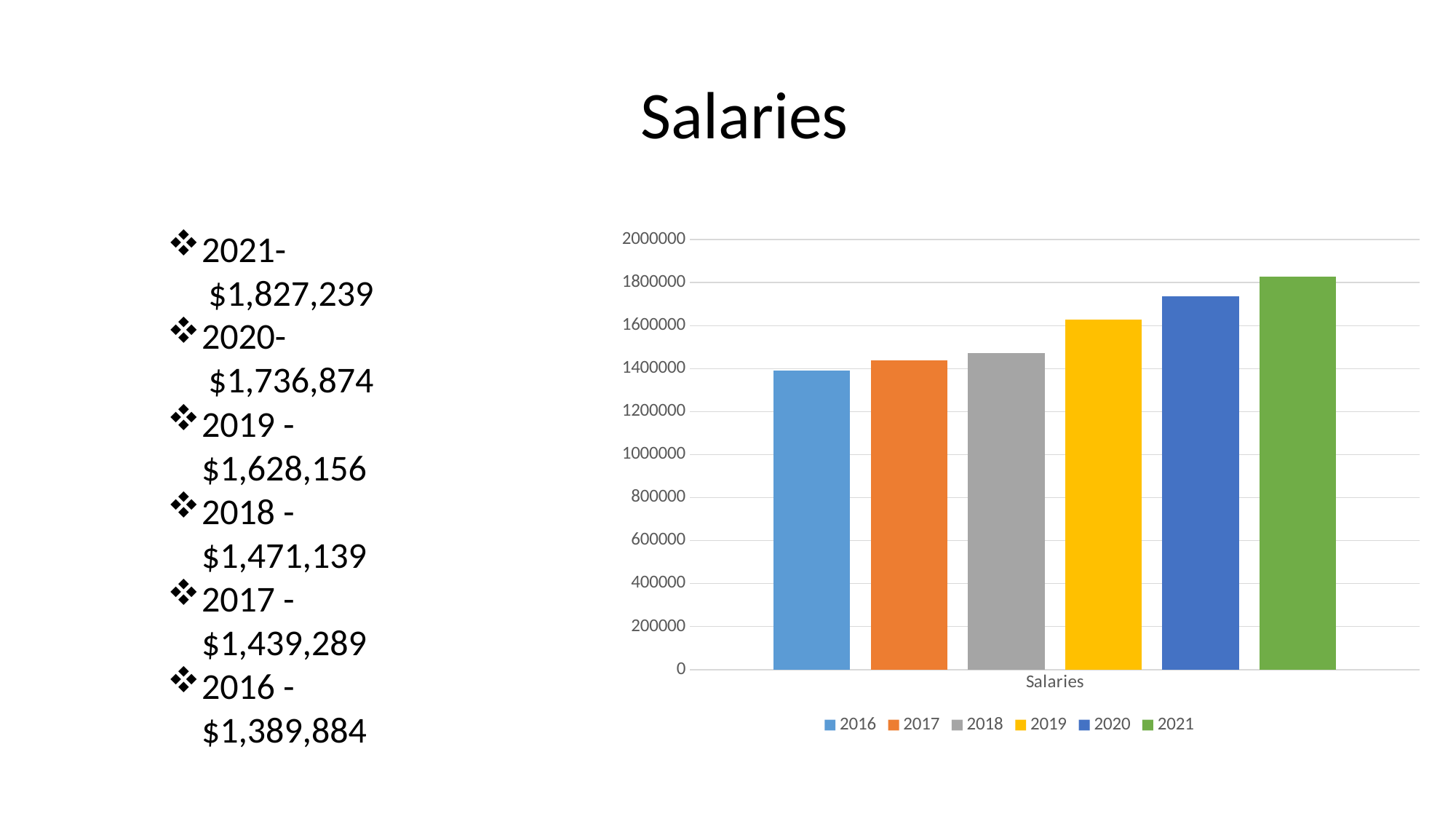
Is the salary bar for 2021 greater or less than 1800000? greater How many series does the legend list? 6 What type of chart is shown on the slide? bar chart Which is larger, the salary bar for 2020 or for 2019? 2020 Which year has the highest salary bar? 2021 What colour is the bar for 2021 in the chart? green Is the salary bar for 2018 greater or less than 1400000? greater Which year has the lowest salary bar? 2016 Is the salary bar for 2020 greater or less than 1800000? less Do the salary bars rise or fall from 2016 to 2021? rise What is the salary value for 2021 as printed on the slide? $1,827,239